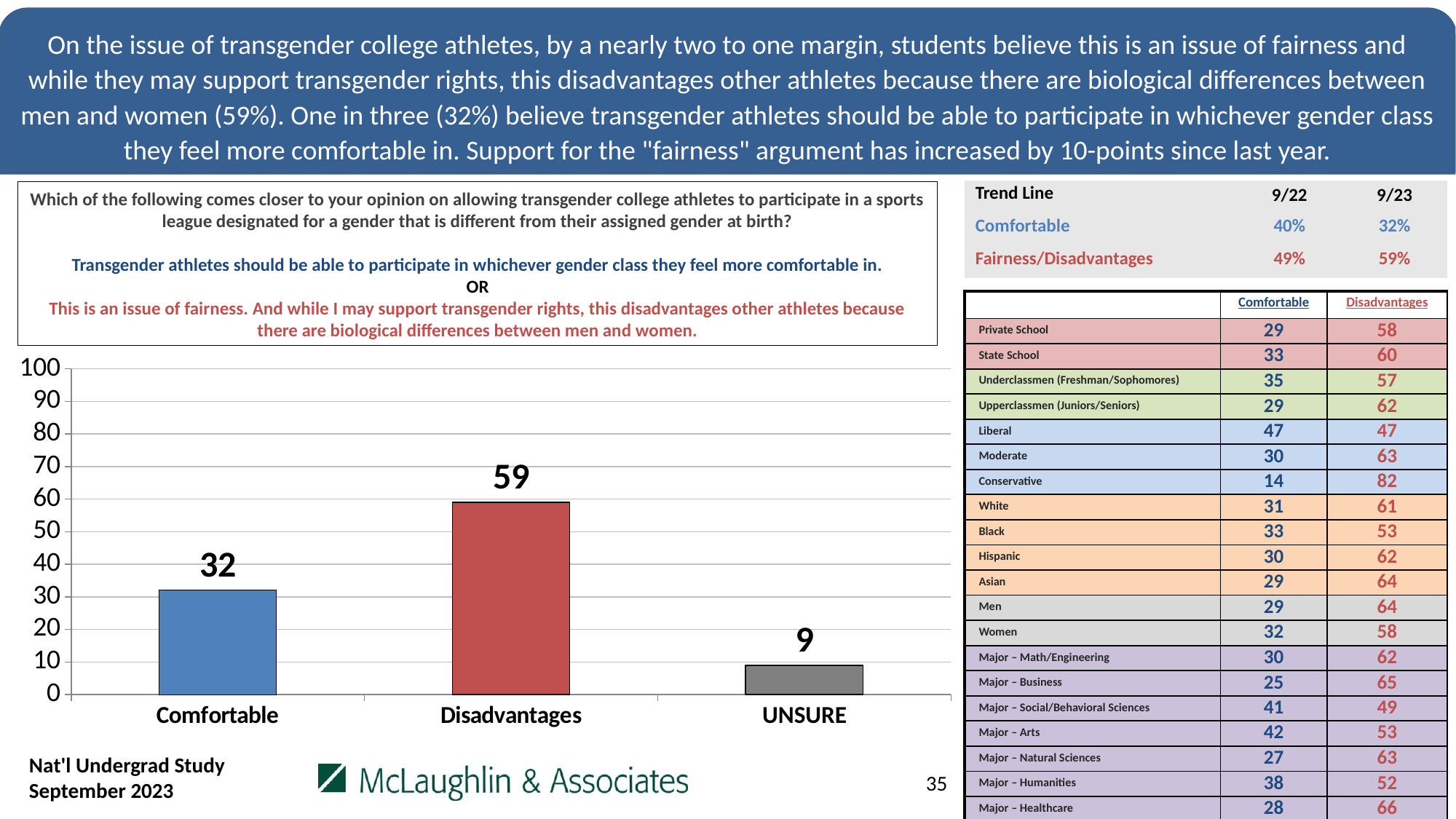
What is the maximum value shown on the vertical axis of the bar chart? 100 What is the value for UNSURE in the bar chart? 9 Which is larger in the bar chart, Comfortable or UNSURE? Comfortable What is the difference between the Disadvantages and Comfortable values in the bar chart? 27 How many categories are shown in the bar chart? 3 Which category has the highest value in the bar chart? Disadvantages What colour is the Disadvantages bar in the bar chart? red What is the value for Disadvantages in the bar chart? 59 What is the value for Comfortable in the bar chart? 32 Is the value for Disadvantages in the bar chart greater or less than 50? greater What kind of chart is shown on the slide? bar chart Which category has the lowest value in the bar chart? UNSURE